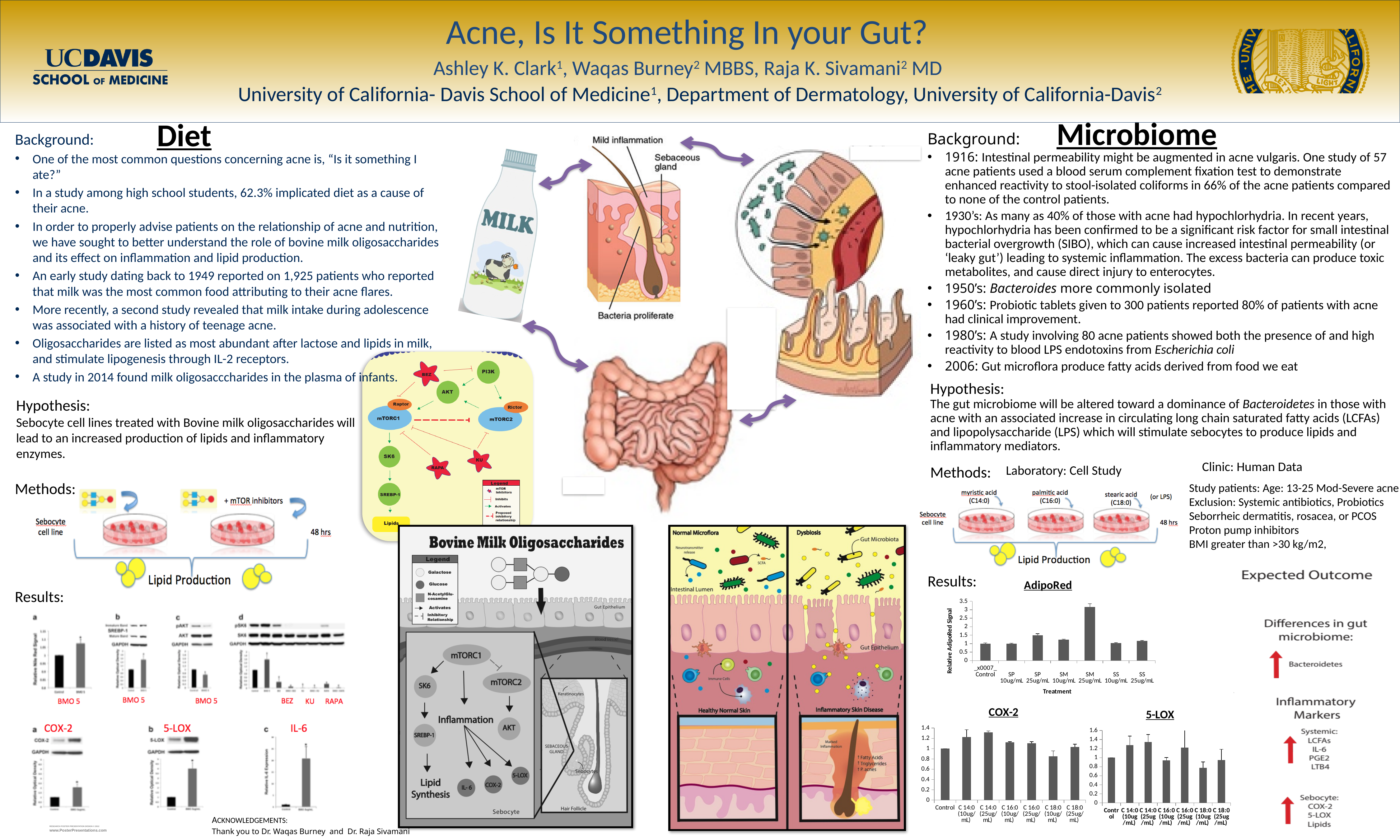
In the AdipoRed chart, which is larger, the value for SM 25ug/mL or the value for SP 25ug/mL? SM 25ug/mL In the AdipoRed chart, is the value for SM 25ug/mL greater or less than 2.5? greater What is the y-axis title of the AdipoRed chart? Relative AdipoRed Signal In the AdipoRed chart, is the value for SP 25ug/mL greater or less than 1? greater In the COX-2 chart, is the value for C 18:0 (10ug/mL) greater or less than 1? less In the 5-LOX chart, which category has the lowest value? C 18:0 (10ug/mL) What kind of chart is the AdipoRed chart? bar chart In the AdipoRed chart, which treatment has the highest relative AdipoRed signal? SM 25ug/mL In the COX-2 chart, which is larger, the value for C 14:0 (10ug/mL) or the value for C 18:0 (10ug/mL)? C 14:0 (10ug/mL) In the COX-2 chart, which category has the lowest value? C 18:0 (10ug/mL) How many treatment categories are shown in the AdipoRed chart? 7